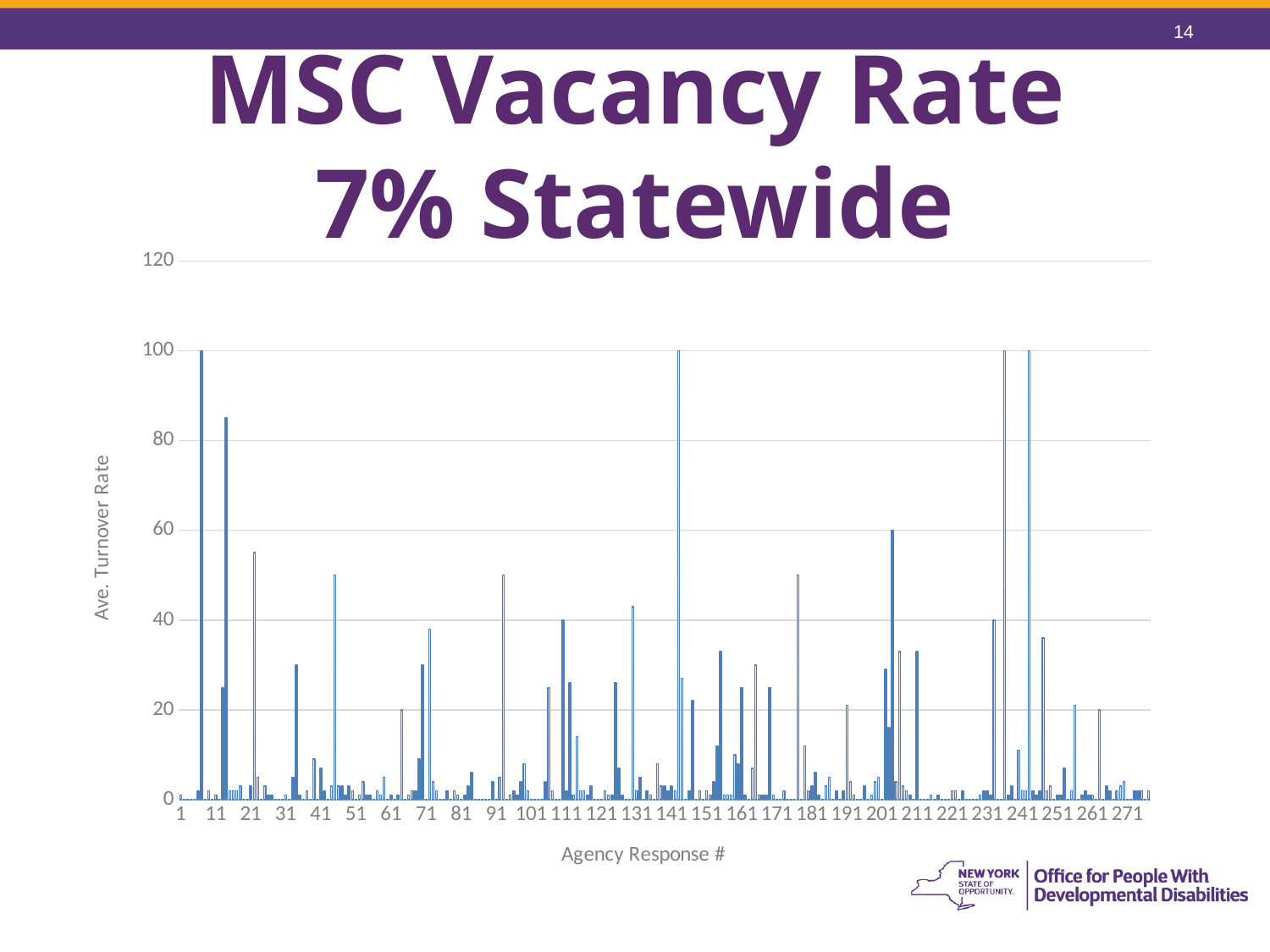
What is the label of the vertical axis? Ave. Turnover Rate What is the highest value reached by any bar on the chart? 100 Is the tallest bar on the chart greater or less than 80? greater What is the label of the horizontal axis? Agency Response # Is the bar near Agency Response #21 greater or less than 60? less What kind of chart is shown on the slide? bar chart Does any bar on the chart exceed 100? No How many bars on the chart reach the 100 gridline? 4